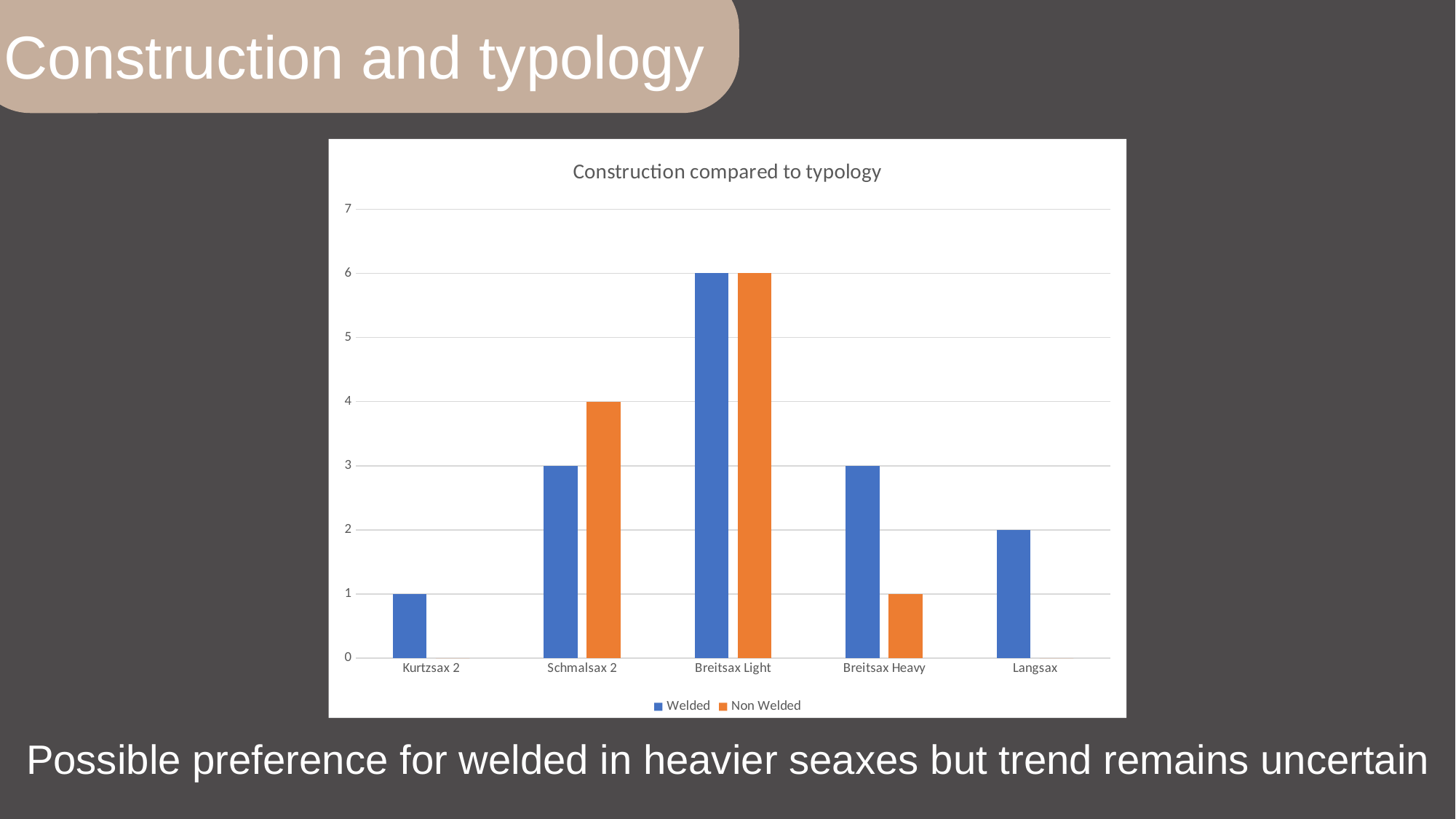
Is the Welded value for Breitsax Light greater or less than 5? greater What is the Non Welded value for Schmalsax 2? 4 What is the Welded value for Langsax? 2 How many categories are shown on the x axis? 5 For Schmalsax 2, which is larger: the Welded or the Non Welded value? Non Welded What type of chart is shown on the slide? bar chart What is the title of the chart? Construction compared to typology Which category has the highest Welded value? Breitsax Light Which category has the lowest Welded value? Kurtzsax 2 How many series does the legend list? 2 What is the Welded value for Breitsax Light? 6 What is the difference between the Welded and Non Welded values for Breitsax Heavy? 2